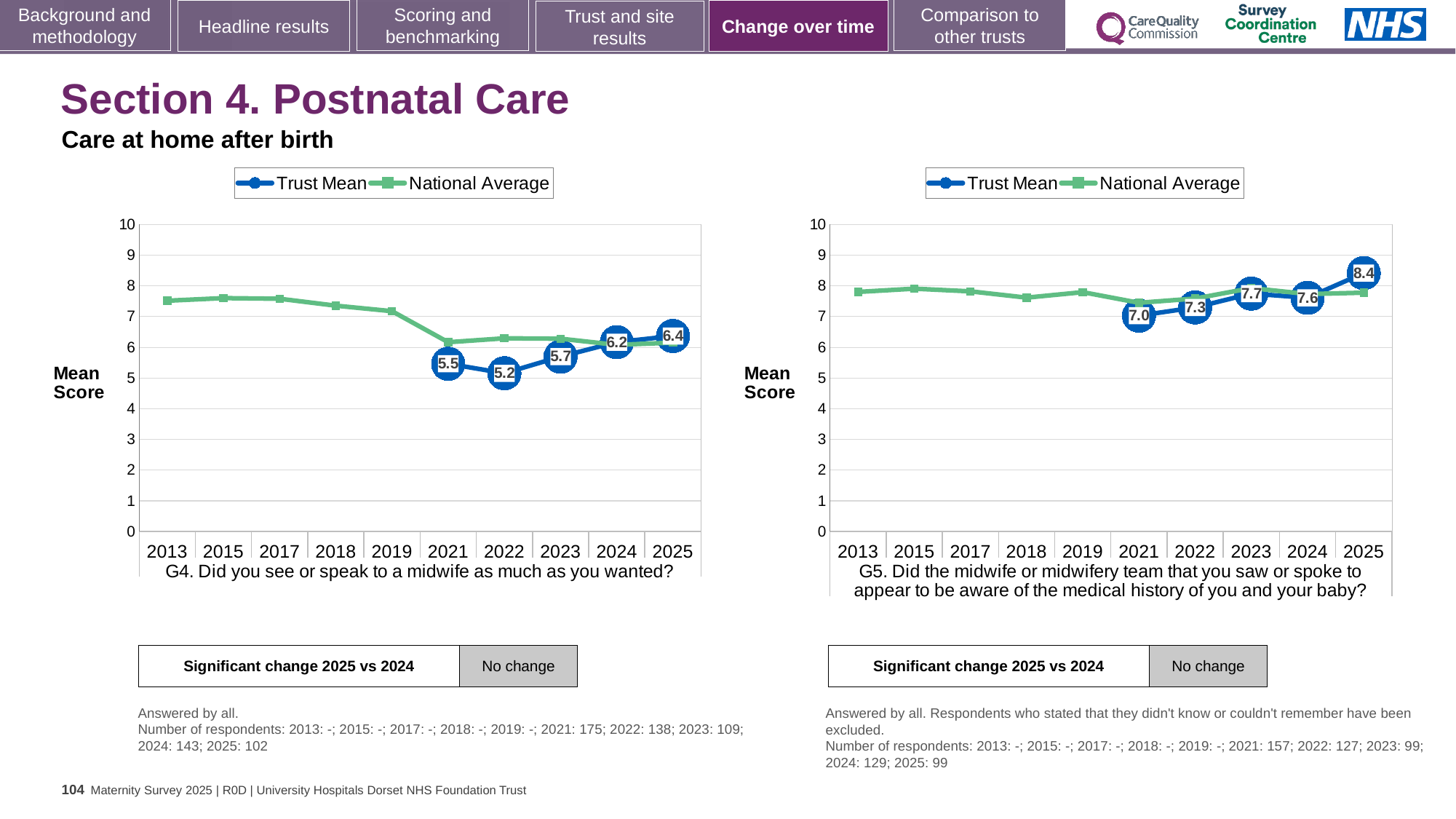
In the G5 chart (right), is the Trust Mean for 2023 or 2024 larger? 2023 In the G4 chart (left), is the National Average for 2013 greater or less than 7? greater In the G4 chart (left), what is the Trust Mean for 2022? 5.2 In the G4 chart (left), what is the Trust Mean for 2025? 6.4 In the G5 chart (right), what is the Trust Mean for 2025? 8.4 In the G5 chart (right), what is the Trust Mean for 2021? 7.0 In the G4 chart (left), what is the difference between the Trust Mean for 2025 and 2021? 0.9 In the G4 chart (left), which year has the lowest labelled Trust Mean? 2022 What kind of chart is the G5 chart (right)? Line chart In the G5 chart (right), what is the difference between the Trust Mean for 2025 and 2024? 0.8 How many series does the legend of the G4 chart (left) list? 2 In the G5 chart (right), which year has the highest labelled Trust Mean? 2025